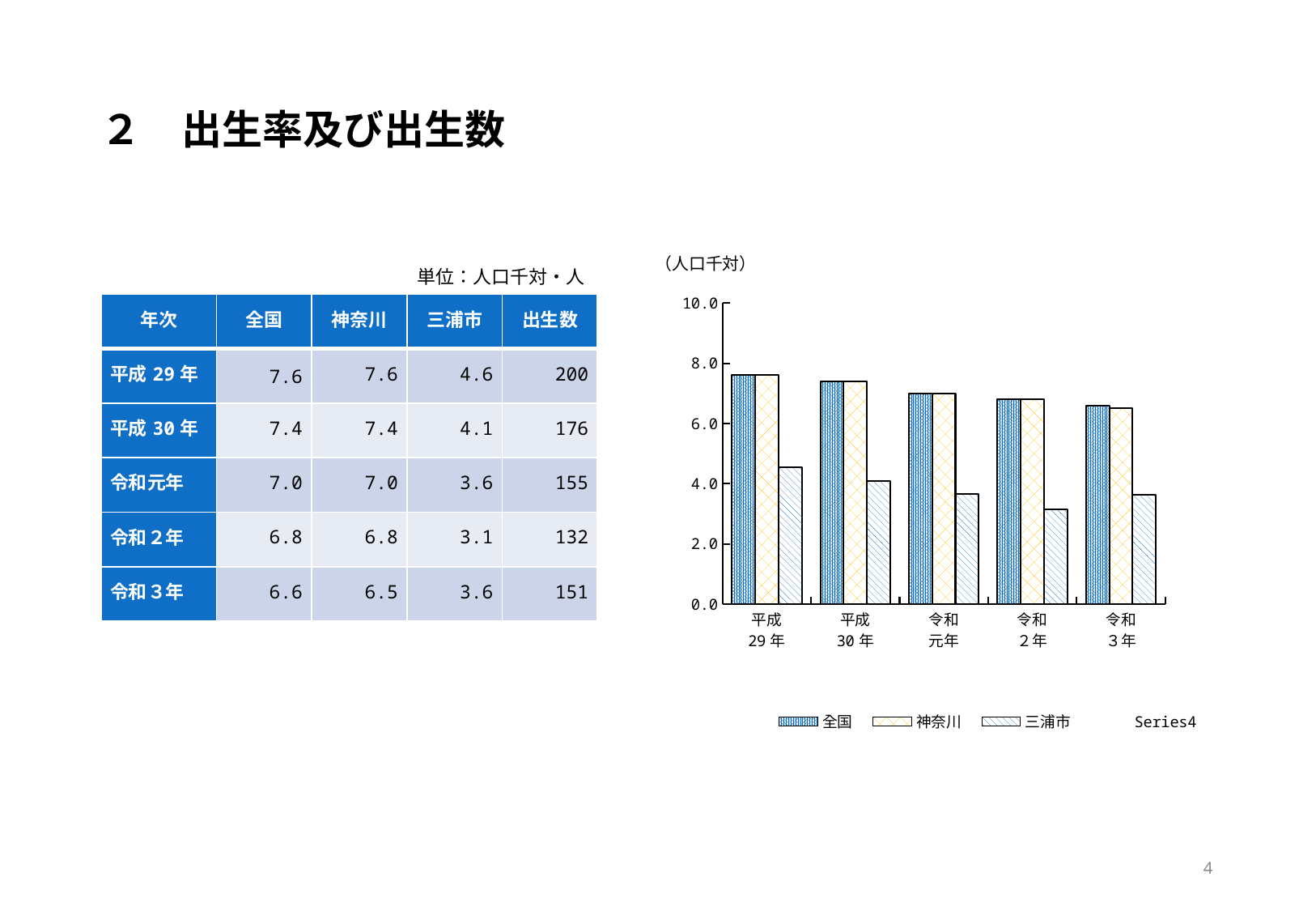
Do the values for 全国 rise or fall from 平成29年 to 令和3年? fall In which year is the value for 三浦市 lowest? 令和2年 Is the value for 三浦市 in 令和2年 greater or less than 4.0? less Is the value for 全国 in 平成29年 greater or less than 6.0? greater Is the value for 神奈川 in 令和3年 greater or less than 8.0? less In 平成29年, which is larger, the value for 全国 or the value for 三浦市? 全国 In which year is the value for 全国 highest? 平成29年 How many bars are plotted for each year group in the chart? 3 What kind of chart is shown on the slide? bar chart How many year categories are shown on the x axis of the chart? 5 What unit is shown above the chart's y axis? 人口千対